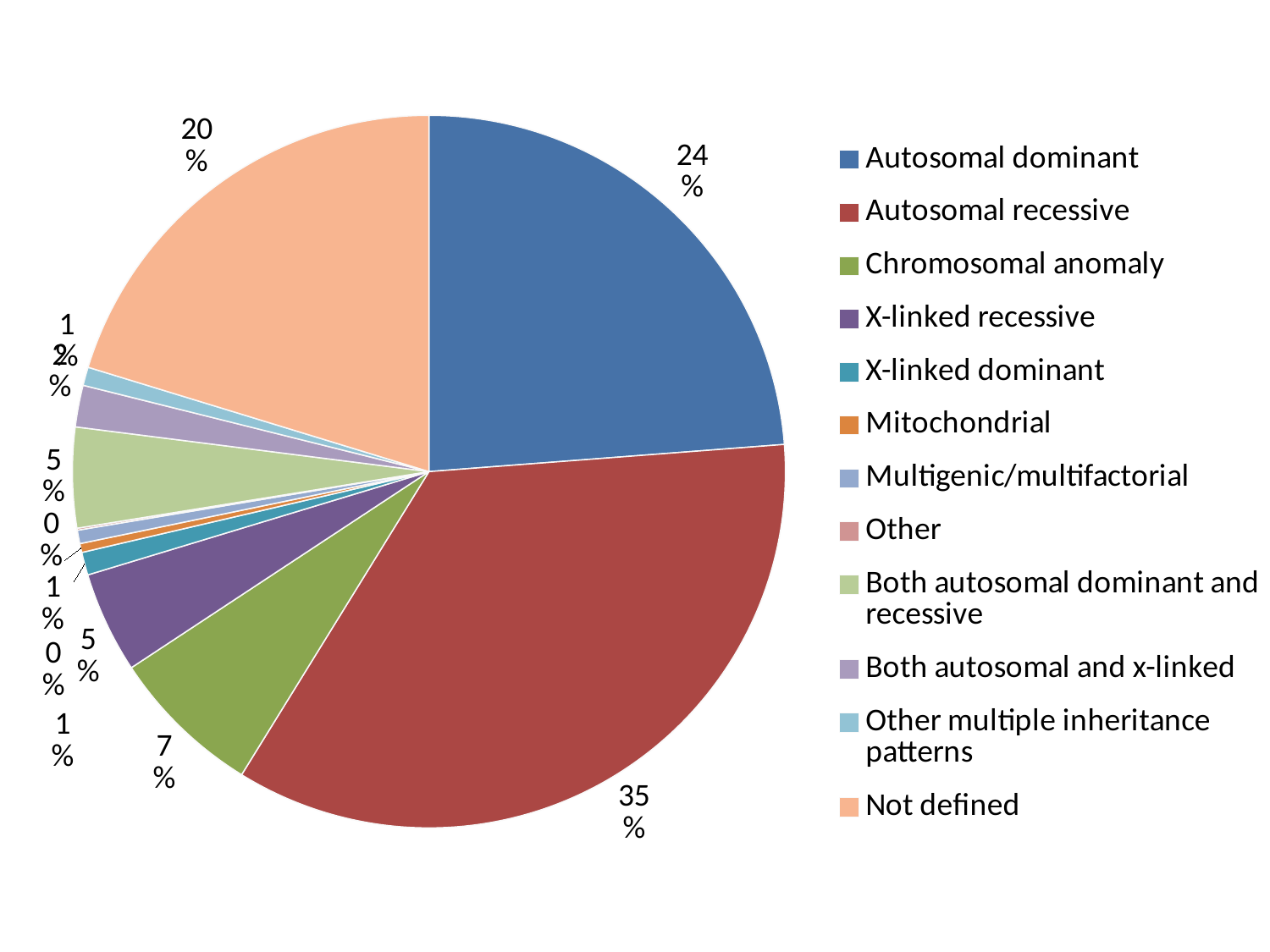
Which category has the largest slice of the pie chart? Autosomal recessive What kind of chart is shown on the slide? pie chart What percentage of the pie is Chromosomal anomaly? 7% How many categories does the legend of the pie chart list? 12 What share of the pie is labelled Not defined? 20% What percentage of the pie is Autosomal dominant? 24% Which is larger, the Not defined slice or the Chromosomal anomaly slice? Not defined Which is larger, the Autosomal dominant slice or the Not defined slice? Autosomal dominant What percentage of the pie is Autosomal recessive? 35% What colour is the Autosomal dominant slice in the pie chart? blue What is the difference in percentage points between Autosomal recessive and Autosomal dominant? 11 What percentage of the pie is X-linked recessive? 5%